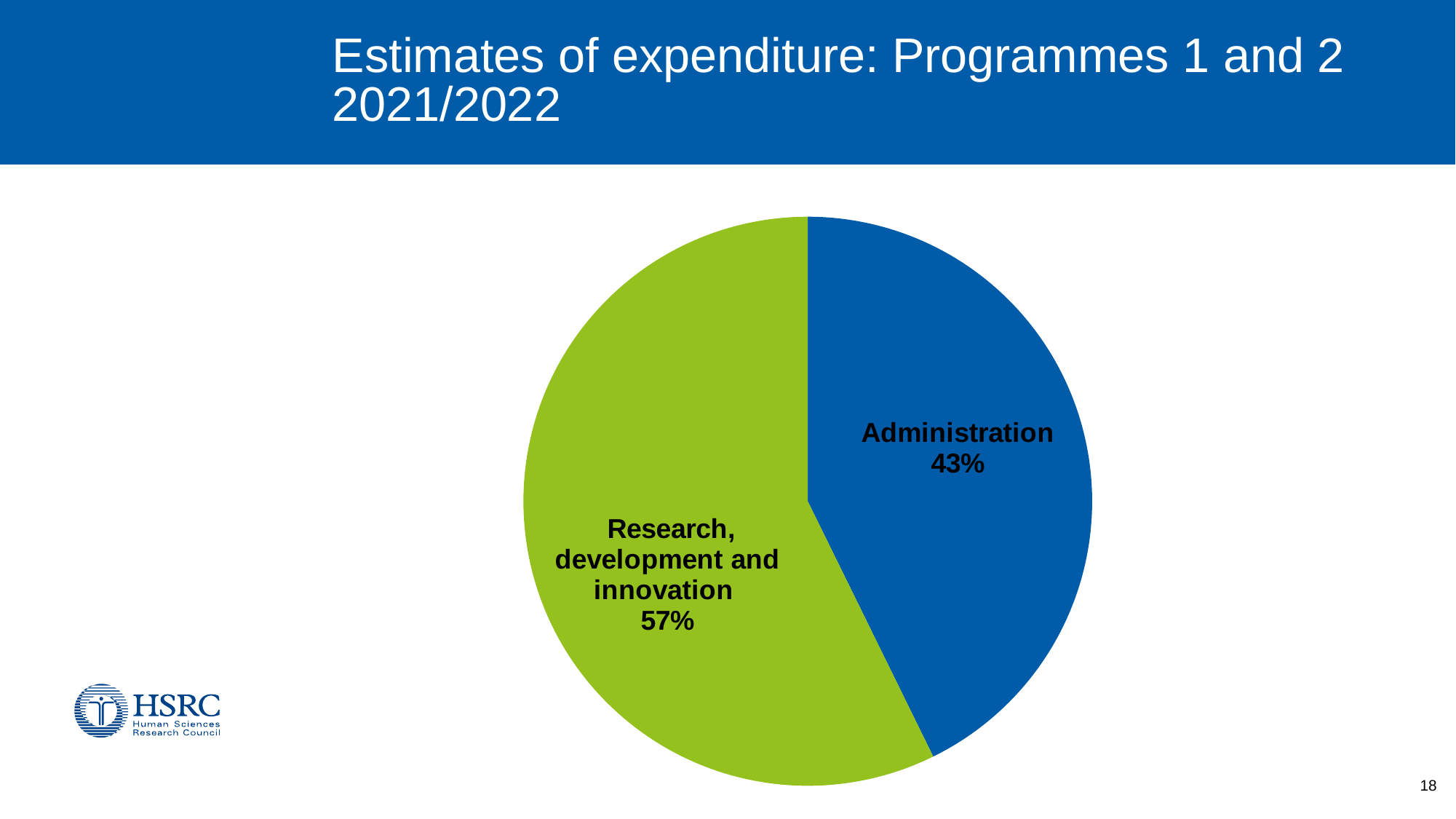
What is the difference in percentage points between the Research, development and innovation share and the Administration share? 14 How many slices does the pie chart have? 2 What share of expenditure is allocated to Research, development and innovation? 57% What is the title of the slide containing the pie chart? Estimates of expenditure: Programmes 1 and 2 2021/2022 What kind of chart is shown on the slide? pie chart Which programme has the smaller share of expenditure? Administration What colour is the Administration slice? blue What is the combined share of the two slices in the pie chart? 100% Which programme has the larger share of expenditure? Research, development and innovation Is the share for Administration larger or smaller than the share for Research, development and innovation? smaller What share of expenditure is allocated to Administration? 43%